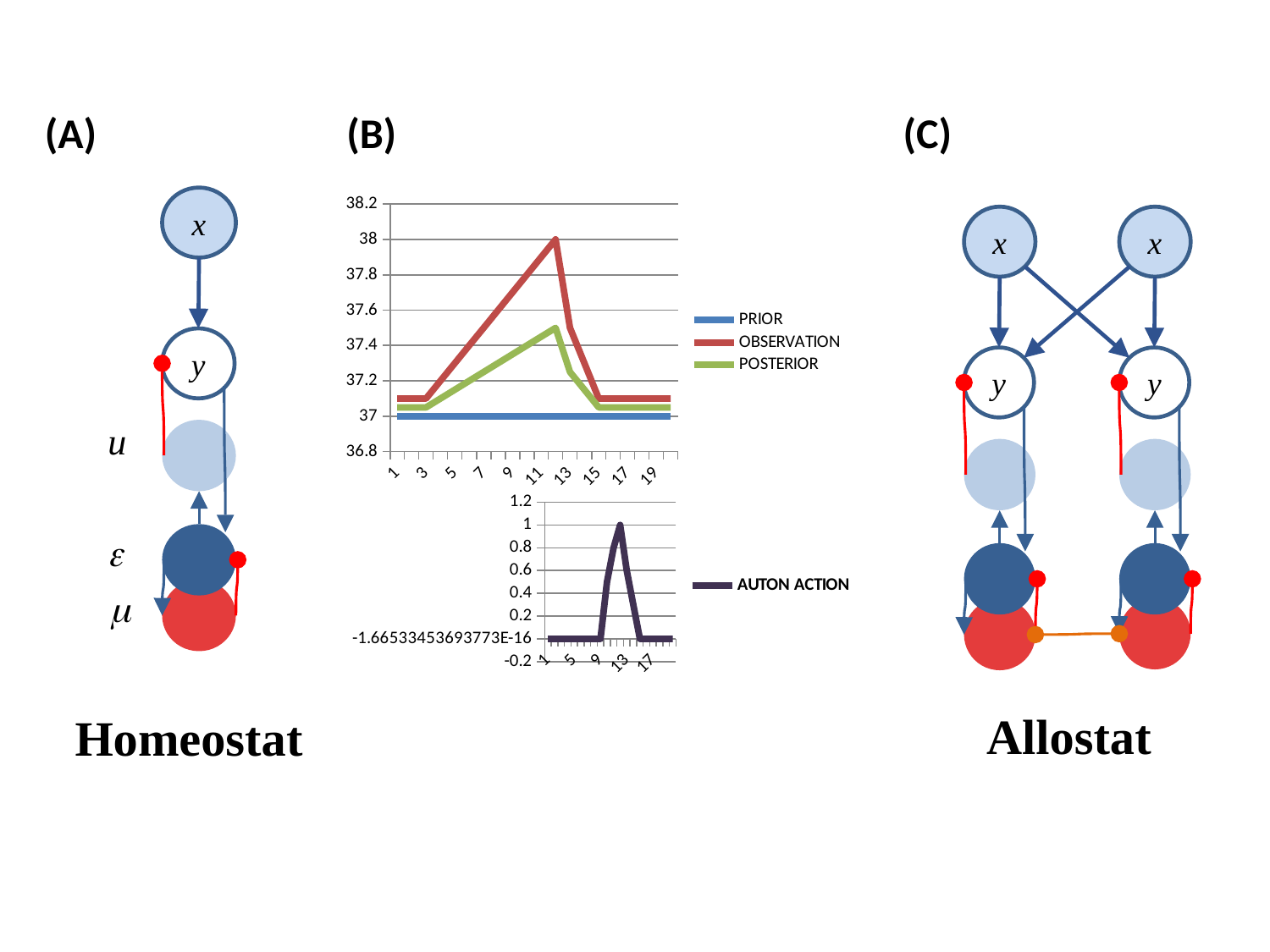
In the upper chart in panel (B), what is the peak value of the OBSERVATION series? 38 In the upper chart in panel (B), which is larger at its peak, OBSERVATION or POSTERIOR? OBSERVATION In the upper chart in panel (B), is the peak value of the POSTERIOR series greater or less than 37.4? greater What are the legend entries of the upper chart in panel (B)? PRIOR, OBSERVATION, POSTERIOR In the lower chart in panel (B), what is the peak value of the AUTON ACTION series? 1 In the upper chart in panel (B), which series stays lowest across the whole x axis? PRIOR In the upper chart in panel (B), what is the difference between the peak of the OBSERVATION series and the PRIOR value? 1 In the upper chart in panel (B), what constant value does the PRIOR series hold? 37 How many series does the legend of the upper chart in panel (B) list? 3 How many series does the legend of the lower chart in panel (B) list? 1 In the upper chart in panel (B), which series reaches the highest value? OBSERVATION What kind of chart is the upper chart in panel (B)? line chart